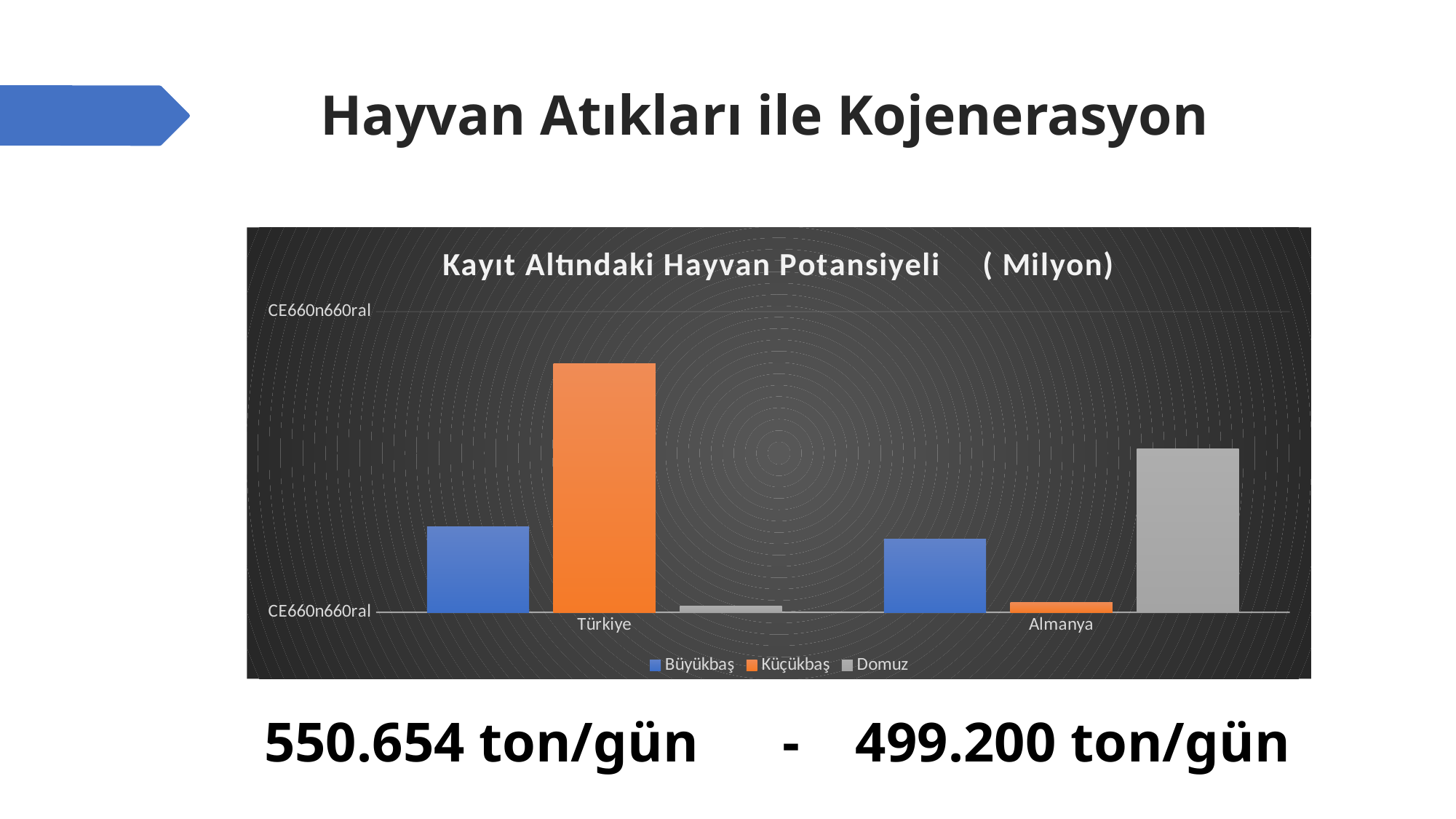
Which series has the highest value for Türkiye? Küçükbaş How many series does the chart legend list? 3 Which country has the larger Küçükbaş value, Türkiye or Almanya? Türkiye How many countries (categories) are shown on the x axis of the chart? 2 What kind of chart is shown on the slide? bar chart What is the title of the chart? Kayıt Altındaki Hayvan Potansiyeli ( Milyon) Which series has the lowest value for Türkiye? Domuz What colour represents the Domuz series in the chart? grey Which country has the larger Domuz value, Türkiye or Almanya? Almanya Which series has the highest value for Almanya? Domuz Which series has the lowest value for Almanya? Küçükbaş Which bar is the tallest in the whole chart? Küçükbaş for Türkiye